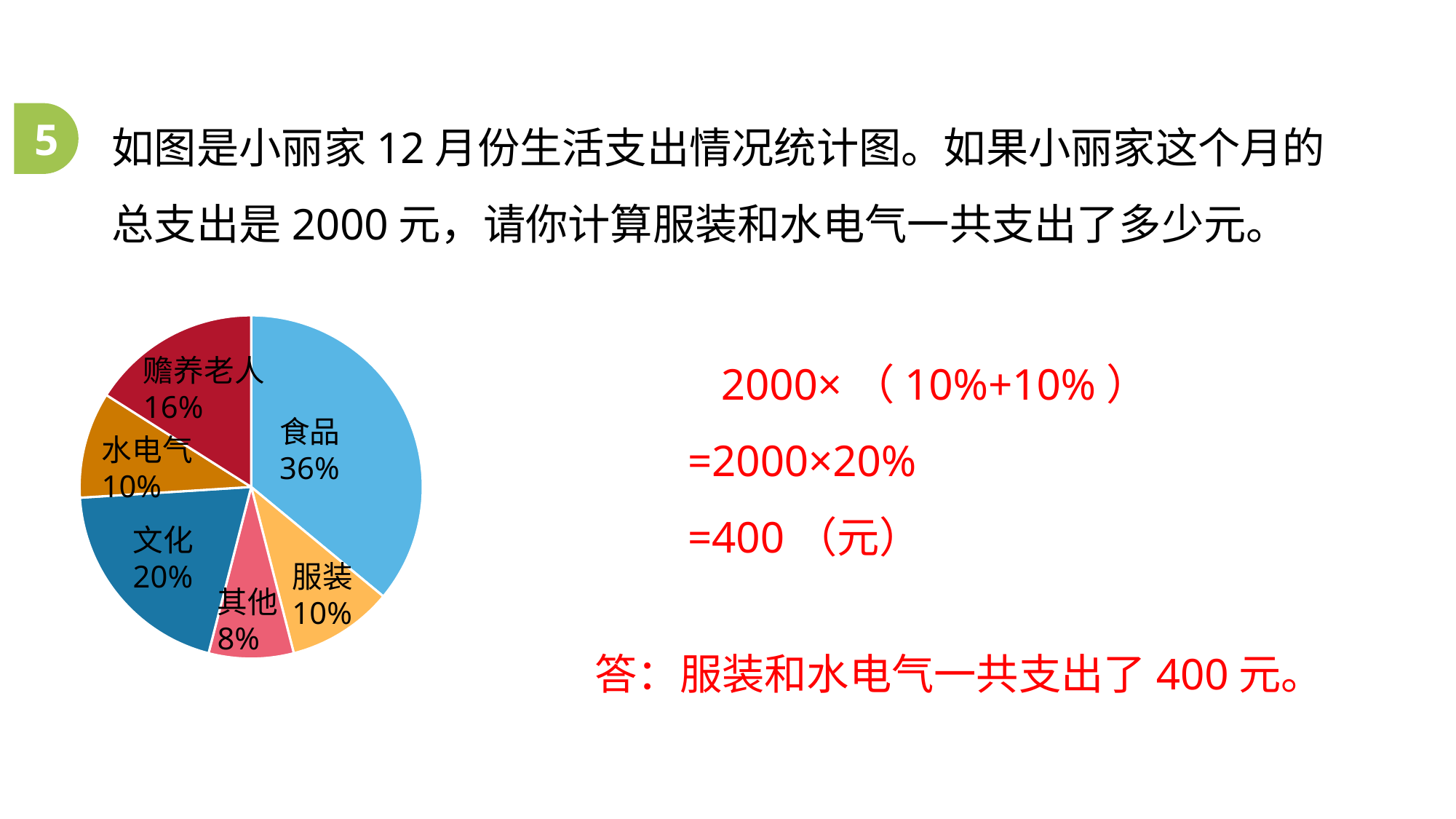
What is the combined share of 服装 and 水电气? 20% What share of the pie does 其他 take? 8% How many slices does the pie chart have? 6 What kind of chart is shown on the slide? pie chart Which category has the smallest slice of the pie? 其他 What share of the pie does 文化 take? 20% What colour is the 食品 slice? light blue Which category has the largest slice of the pie? 食品 What share of the pie does 食品 take? 36% What is the difference in percentage points between 食品 and 文化? 16 Which is larger, the share for 赡养老人 or the share for 水电气? 赡养老人